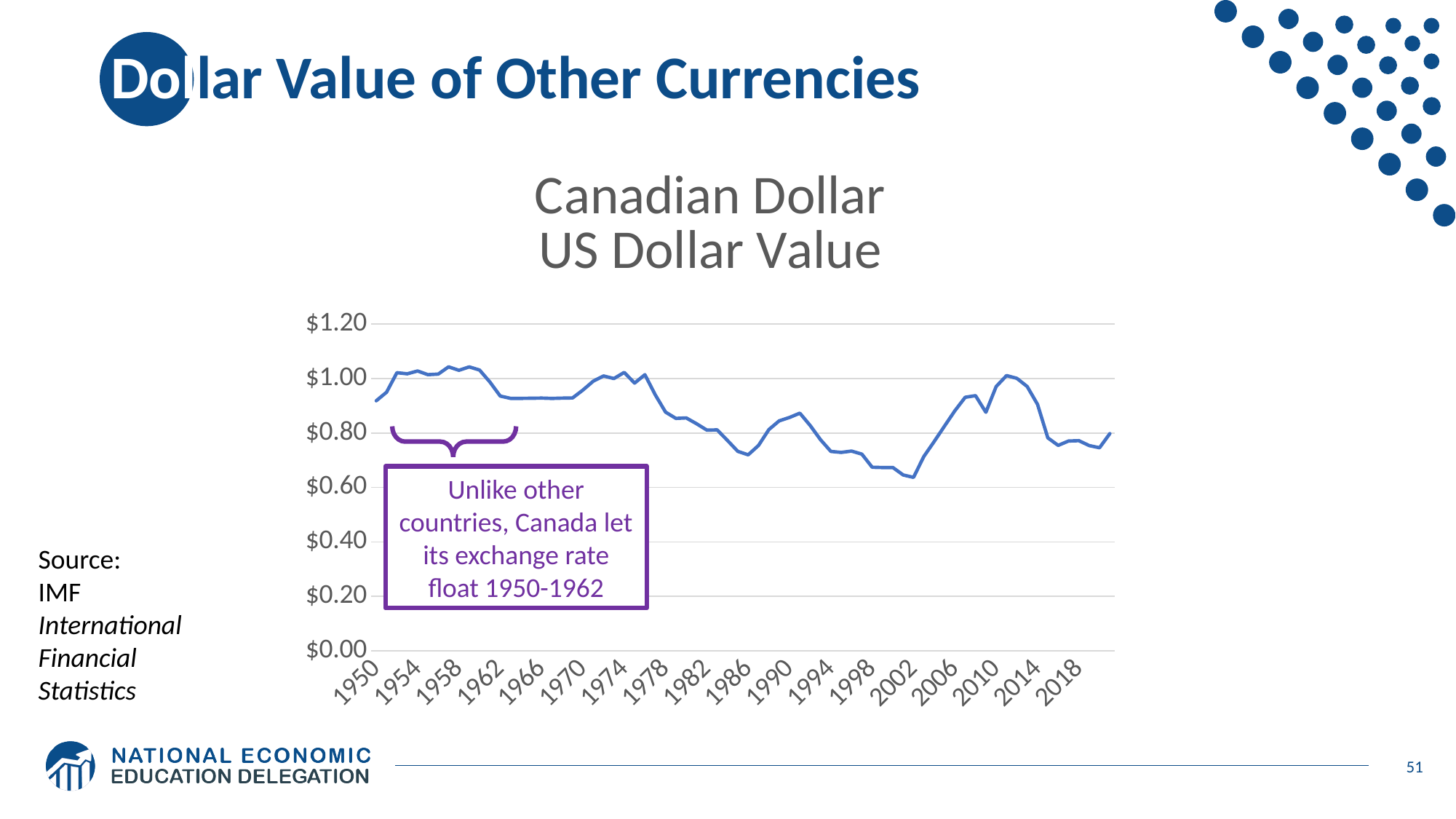
Is the value for 1994 greater or less than $0.80? less Is the value for 1986 greater or less than $0.80? less Is the value for 2014 greater or less than $0.80? greater What kind of chart is shown on the slide? Line chart Does the line rise or fall between 2002 and 2010? Rise According to the annotation box, during which years did Canada let its exchange rate float? 1950-1962 What is the title of the chart? Canadian Dollar US Dollar Value Around which labelled year does the line reach its lowest point? 2002 Does the line rise or fall between 1974 and 1986? Fall How many year labels are shown on the x axis? 18